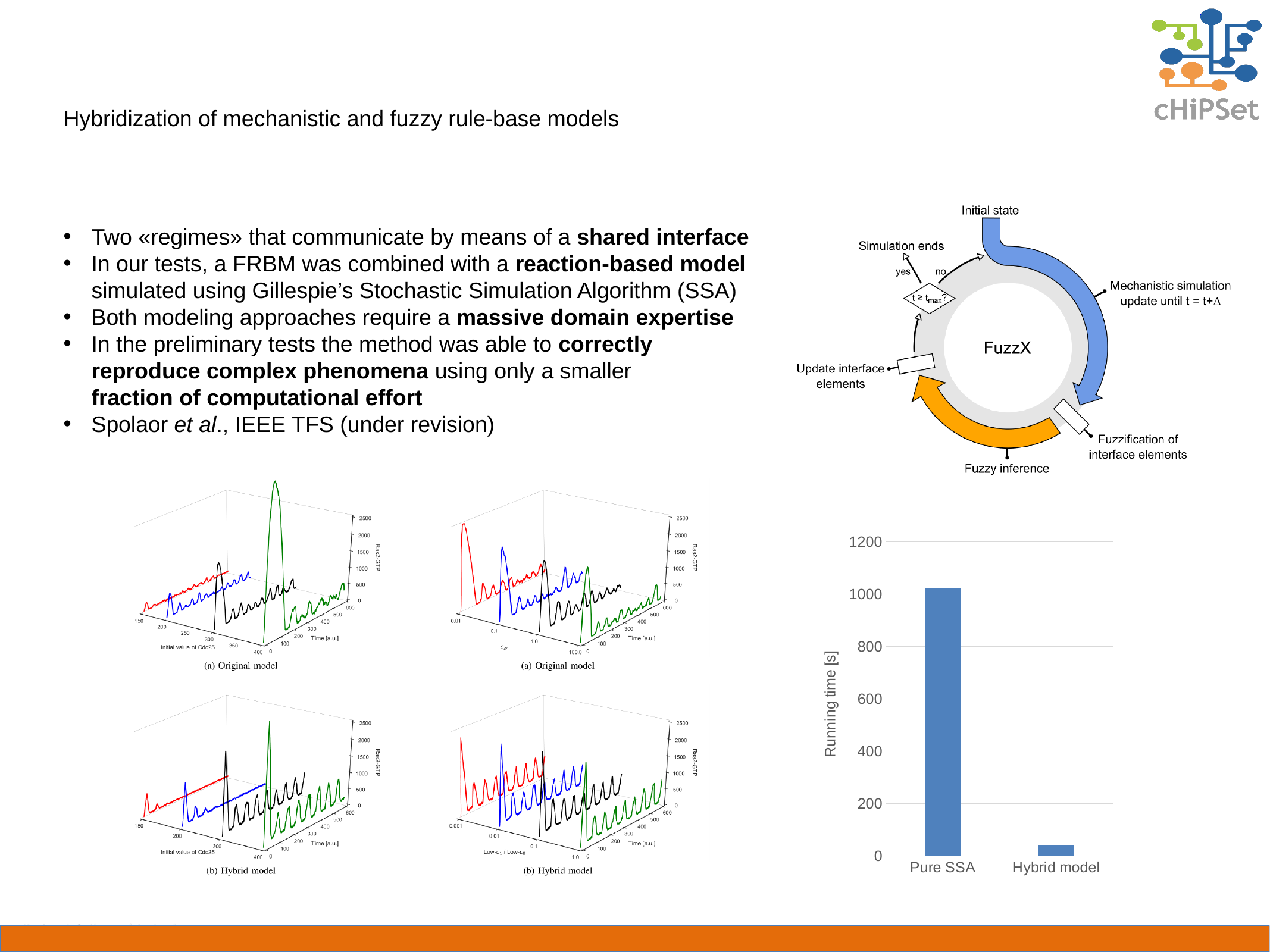
What is the highest tick value shown on the y axis of the bar chart at the bottom right? 1200 In the bar chart at the bottom right, is the running time for Pure SSA greater or less than 1200? less In the bar chart at the bottom right, is the running time for Hybrid model greater or less than 200? less In the bar chart at the bottom right, which has the larger running time, Pure SSA or Hybrid model? Pure SSA In the bar chart at the bottom right, is the running time for Pure SSA greater or less than 800? greater In the bar chart at the bottom right, which category has the lowest running time? Hybrid model In the bar chart at the bottom right, which category has the highest running time? Pure SSA How many categories are shown on the x axis of the bar chart at the bottom right? 2 What kind of chart is the chart at the bottom right of the slide? bar chart In the bar chart at the bottom right, do the values rise or fall from Pure SSA to Hybrid model? fall What is the y-axis title of the bar chart at the bottom right? Running time [s]